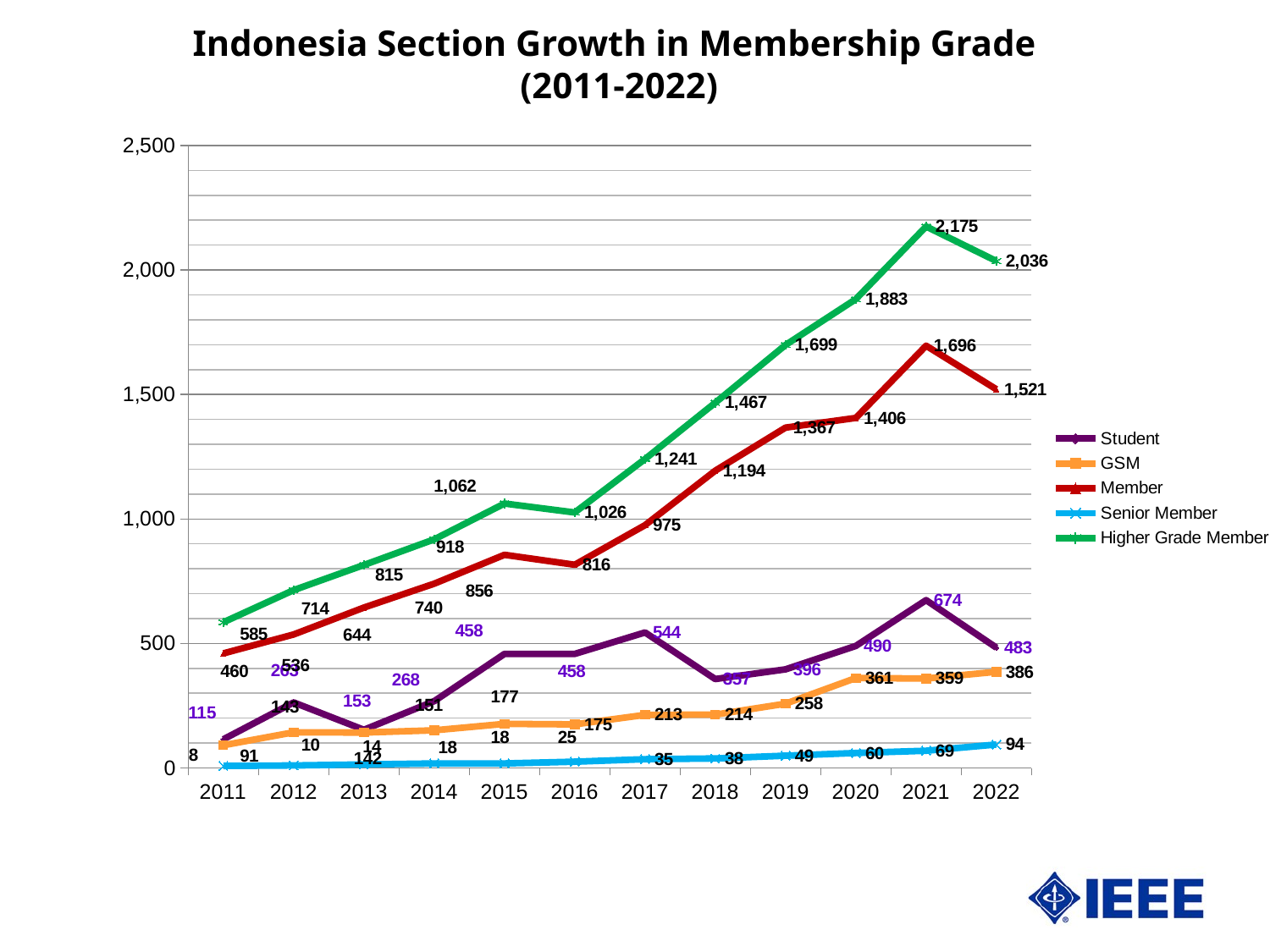
How many years are plotted along the x axis? 12 In which year does the Higher Grade Member series reach its highest value? 2021 What is the value for GSM in 2020? 361 Does the Senior Member series generally rise or fall from 2011 to 2022? Rise How many series does the legend list? 5 What is the value for Higher Grade Member in 2021? 2,175 What is the value for Senior Member in 2022? 94 What is the difference between the Higher Grade Member values in 2021 and 2022? 139 Which is larger in 2019, the Member value or the GSM value? Member What is the value for Member in 2022? 1,521 What type of chart is shown on the slide? Line chart In which year is the Senior Member value lowest? 2011